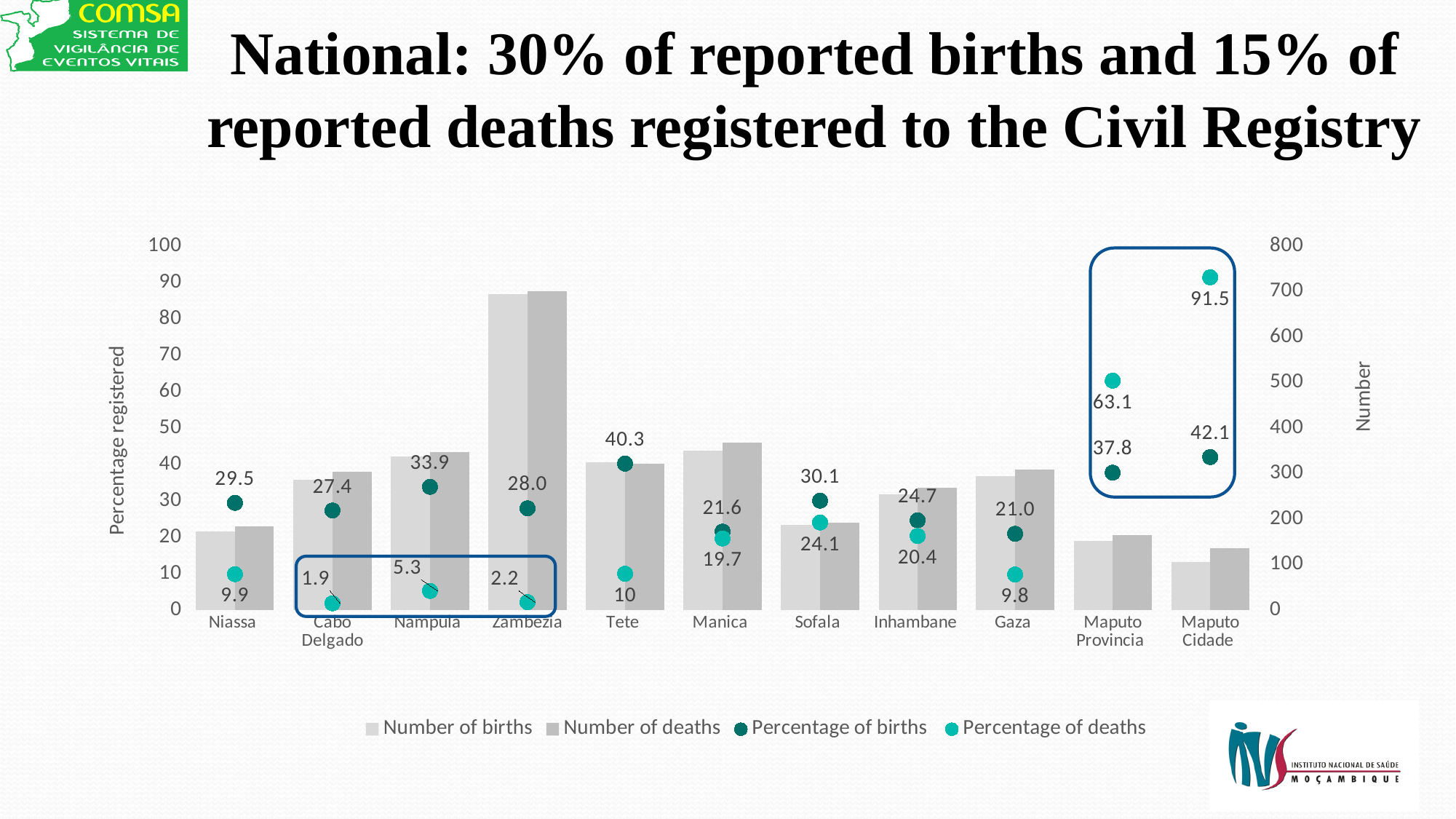
Is the Number of births for Zambezia greater or less than 600? greater How many series does the legend list? 4 For Sofala, which is larger: the Percentage of births or the Percentage of deaths? Percentage of births What is the label of the left vertical axis? Percentage registered What is the difference between the Percentage of deaths and the Percentage of births for Maputo Cidade? 49.4 What is the Percentage of births for Tete? 40.3 What is the Percentage of deaths for Cabo Delgado? 1.9 How many provinces are shown on the x axis? 11 What is the Percentage of deaths for Maputo Provincia? 63.1 Is the Number of births for Niassa greater or less than 200? less Which province has the highest Percentage of deaths? Maputo Cidade Which province has the lowest Percentage of births? Gaza